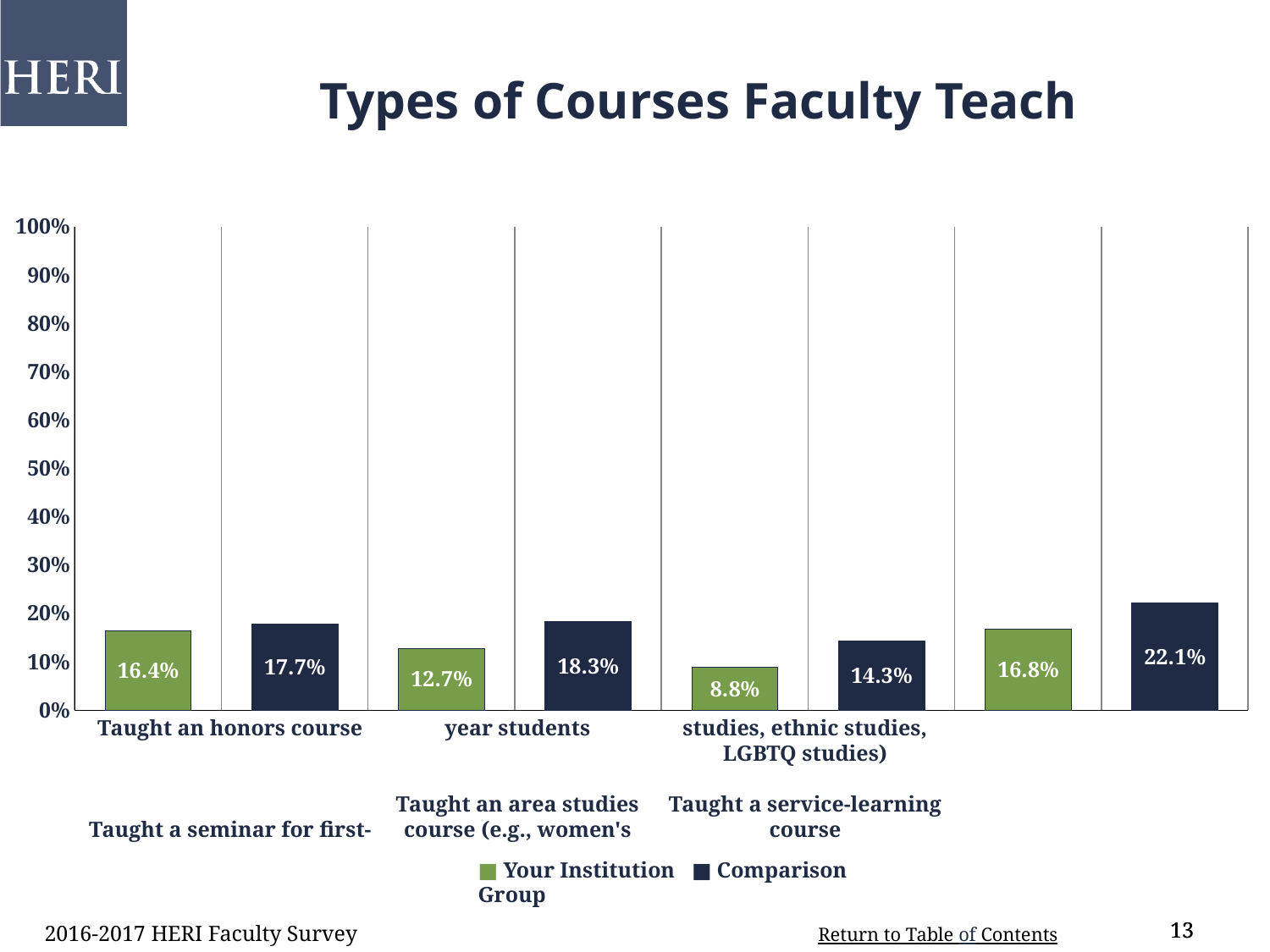
How many series does the legend list? 2 What kind of chart is shown on the slide? Bar chart What is the difference between the Comparison Group and Your Institution values for "Taught a seminar for first-year students"? 5.6% Is the Comparison Group value for "Taught a service-learning course" greater or less than 20%? greater What is the Comparison Group value for "Taught a service-learning course"? 22.1% Which category has the highest Comparison Group value? Taught a service-learning course What is the Comparison Group value for "Taught a seminar for first-year students"? 18.3% Which category has the lowest Your Institution value? Taught an area studies course For "Taught an area studies course", which is larger: Your Institution or Comparison Group? Comparison Group How many course-type categories are shown on the chart? 4 What is the Your Institution value for "Taught an area studies course"? 8.8% What is the value for Your Institution for "Taught an honors course"? 16.4%